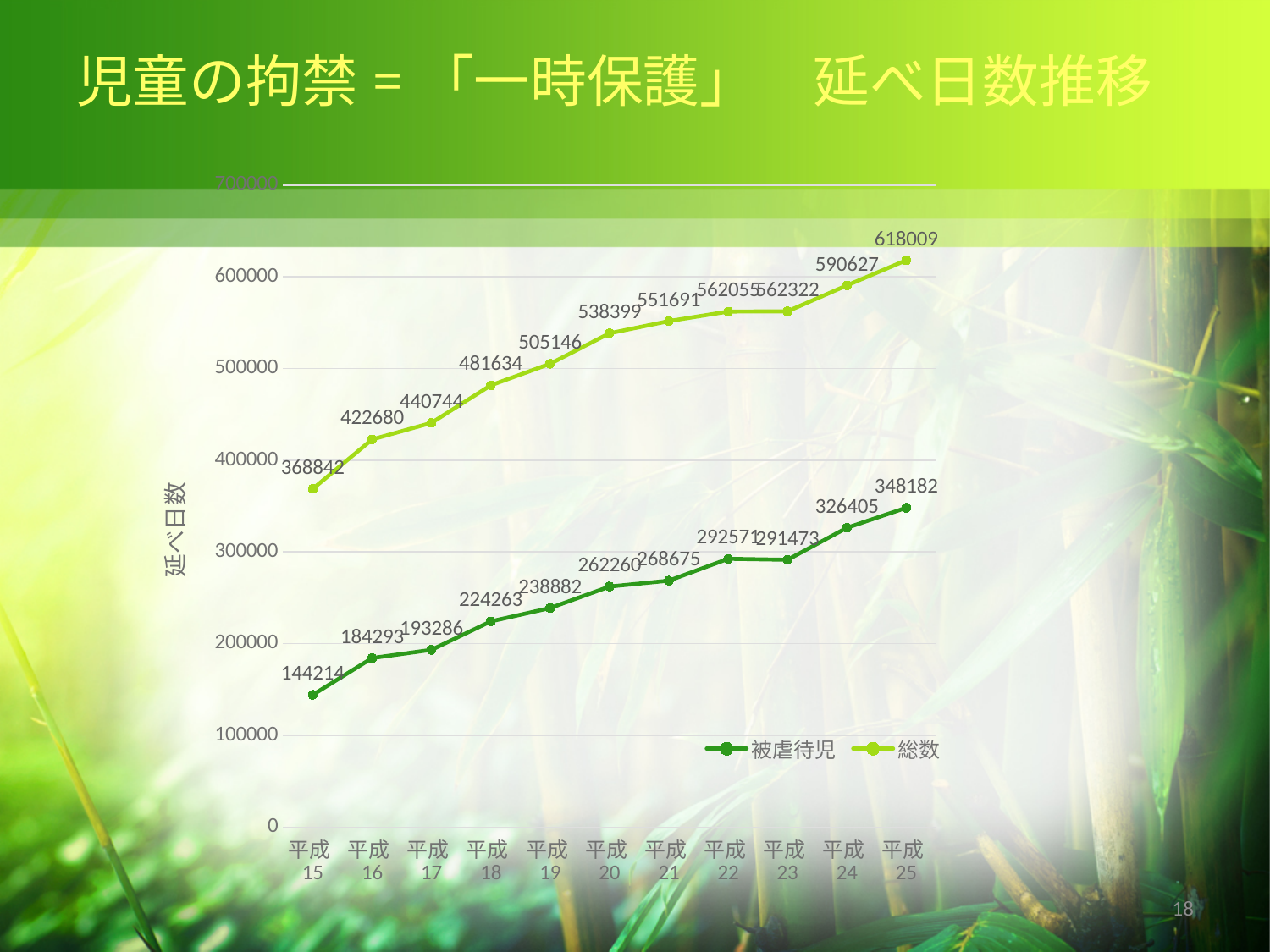
Does the 総数 series generally rise or fall from 平成15 to 平成25? rise Which is larger, the 被虐待児 value for 平成22 or for 平成23? 平成22 In which year is the 総数 value lowest? 平成15 How many series does the legend list? 2 What is the value of 総数 for 平成18? 481634 What type of chart is shown on the slide? line chart What is the value of 被虐待児 for 平成20? 262260 How many years (data points) are plotted along the x axis? 11 What is the difference between 総数 and 被虐待児 in 平成25? 269827 What is the value of 総数 for 平成25? 618009 In which year is the 被虐待児 value highest? 平成25 What is the value of 被虐待児 for 平成15? 144214